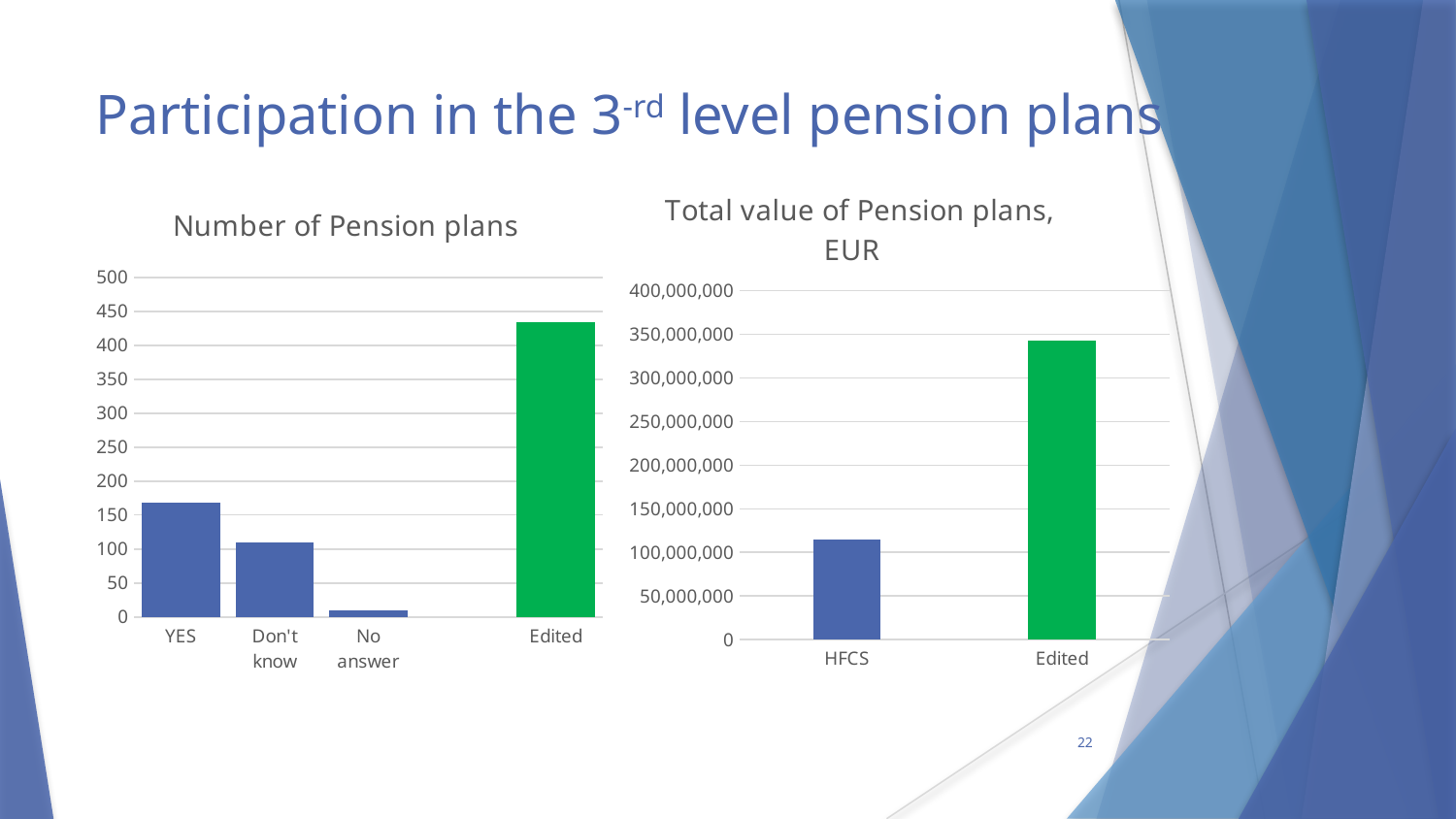
In the 'Number of Pension plans' chart, is the value for YES greater or less than 150? greater In the 'Number of Pension plans' chart, what kind of chart is shown? bar chart In the 'Number of Pension plans' chart, which category has the highest value? Edited In the 'Number of Pension plans' chart, which category has the lowest value? No answer In the 'Total value of Pension plans, EUR' chart, is the value for HFCS greater or less than 150,000,000? less In the 'Number of Pension plans' chart, is the value for Edited greater or less than 400? greater In the 'Total value of Pension plans, EUR' chart, which category has the higher value? Edited In the 'Number of Pension plans' chart, how many categories are shown on the x axis? 4 In the 'Total value of Pension plans, EUR' chart, how many categories are shown on the x axis? 2 What is the title of the chart on the right side of the slide? Total value of Pension plans, EUR In the 'Number of Pension plans' chart, which is larger, YES or Don't know? YES